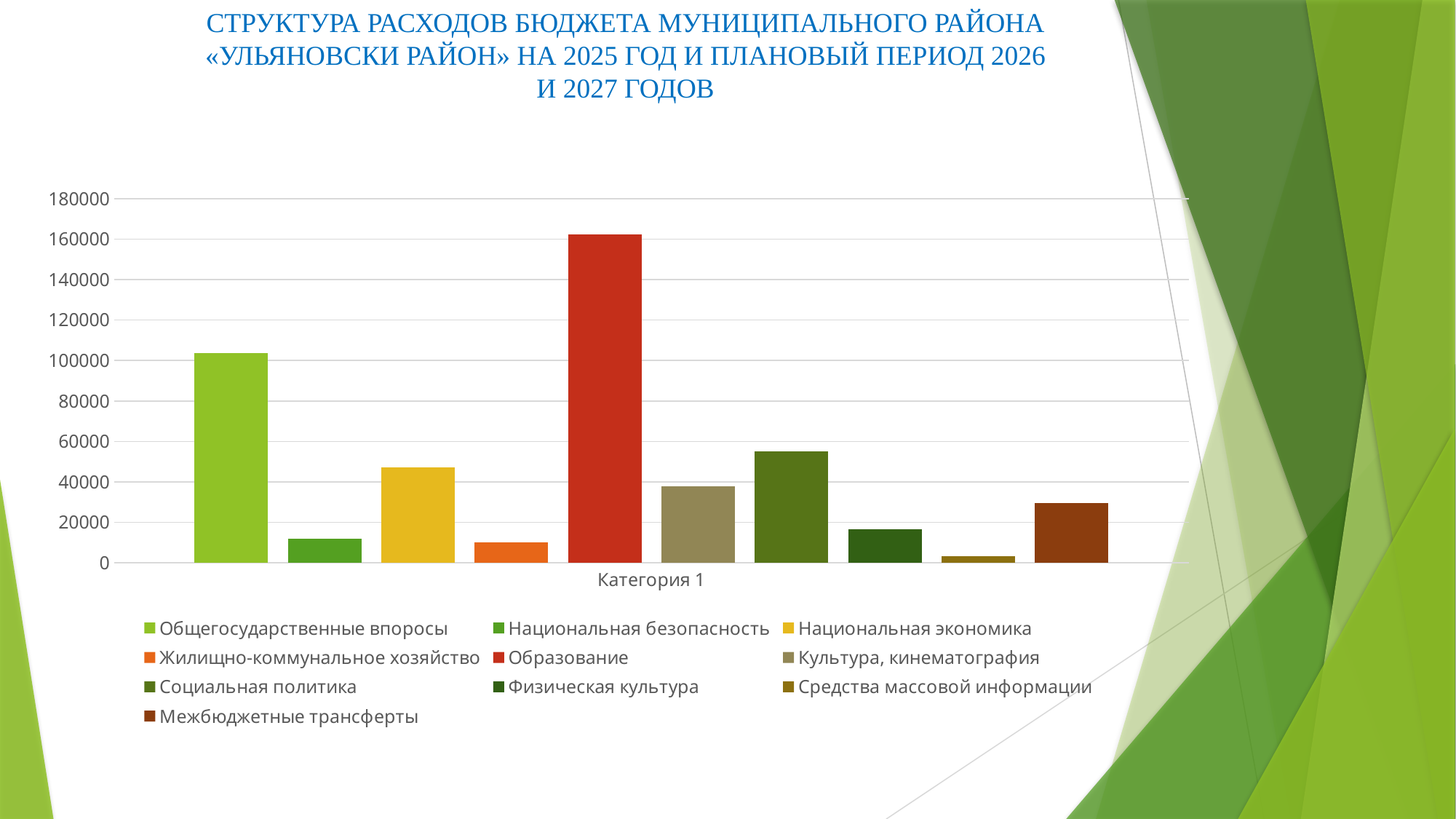
Is the value for Межбюджетные трансферты greater or less than 20000? greater Which is larger, the value for Общегосударственные впоросы or the value for Социальная политика? Общегосударственные впоросы What is the label shown on the x axis under the bars? Категория 1 What colour is the bar for Образование? red How many series does the legend list? 10 Which series has the lowest value? Средства массовой информации Is the value for Национальная экономика greater or less than 60000? less Which series has the highest value? Образование Is the value for Образование greater or less than 140000? greater What kind of chart is shown on the slide? bar chart Which is larger, the value for Культура, кинематография or the value for Физическая культура? Культура, кинематография